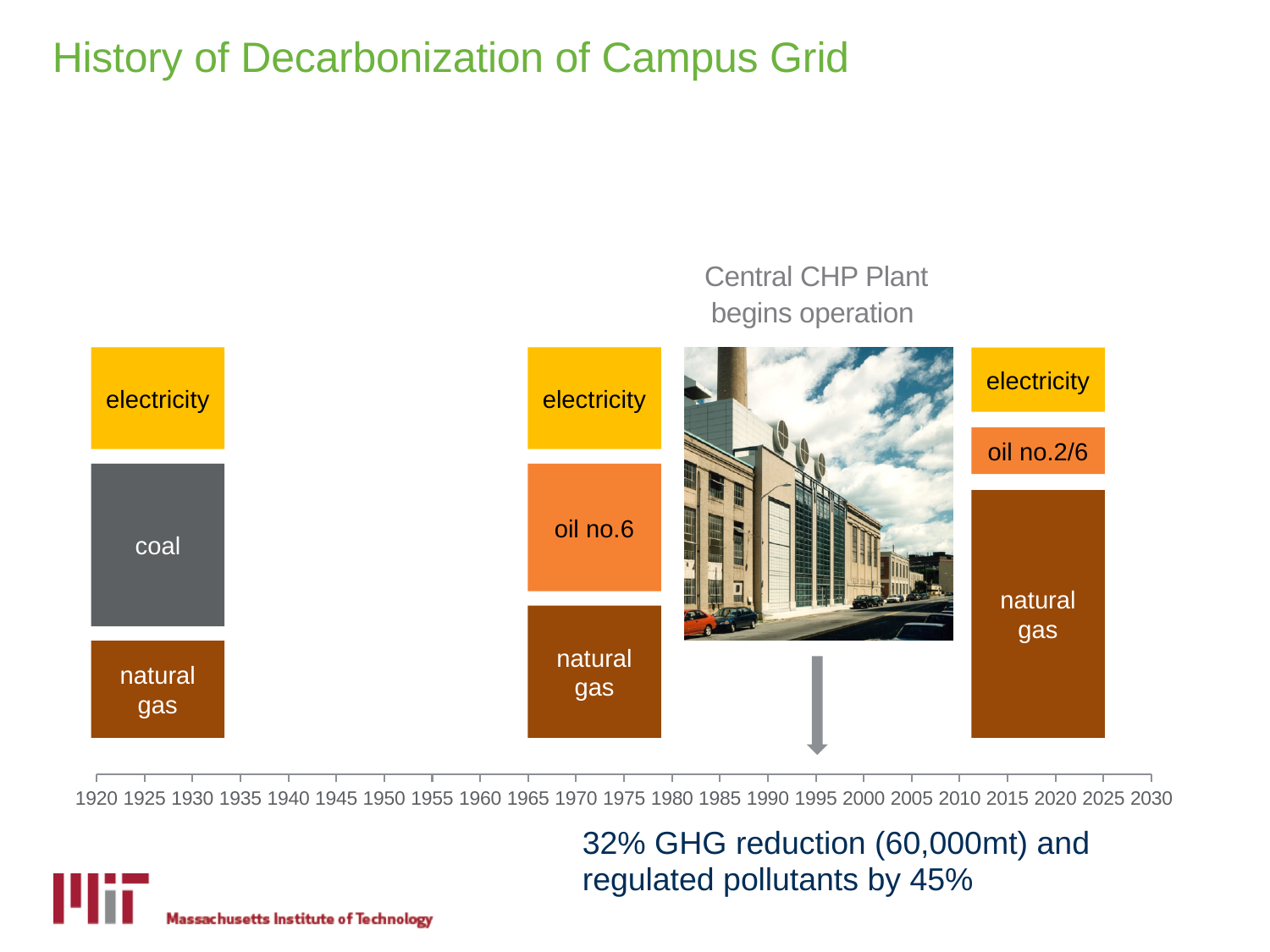
What is the title of the slide? History of Decarbonization of Campus Grid According to the arrow on the timeline, in what year does the Central CHP Plant begin operation? 1995 How many energy-source blocks are in the leftmost stack (around 1920-1935)? 3 What is the last year shown on the timeline axis? 2030 How many year labels are printed along the timeline axis? 23 What is the first year shown on the timeline axis? 1920 How many energy-source blocks are in the rightmost stack (around 2010-2025)? 3 Which energy source appears in the leftmost stack but in neither of the later stacks? coal